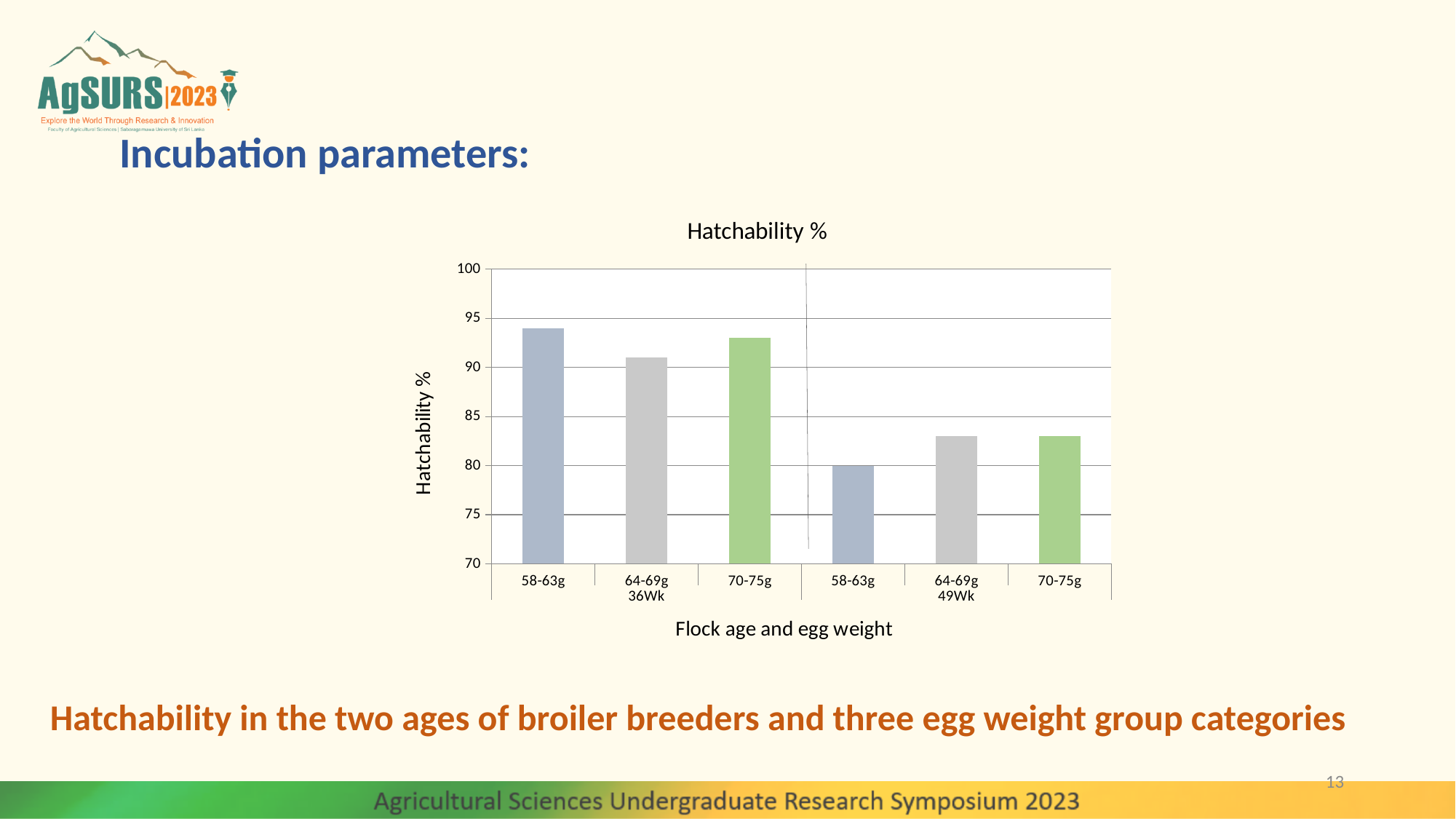
Is the hatchability % for the 58-63g group at 36Wk greater or less than 90? greater Is the hatchability % for the 70-75g group at 49Wk greater or less than 85? less What is the x-axis title of the chart? Flock age and egg weight How many bars are plotted in the chart? 6 What is the hatchability % for the 58-63g egg weight group at 49Wk? 80 Which has a higher hatchability %: the 58-63g group at 36Wk or the 58-63g group at 49Wk? 58-63g at 36Wk What is the title of the chart? Hatchability % What type of chart is shown on the slide? Bar chart Which category has the lowest hatchability %? 58-63g at 49Wk Which has a higher hatchability %: the 64-69g group at 36Wk or the 64-69g group at 49Wk? 64-69g at 36Wk Is the hatchability % for the 70-75g group at 36Wk greater or less than 90? greater